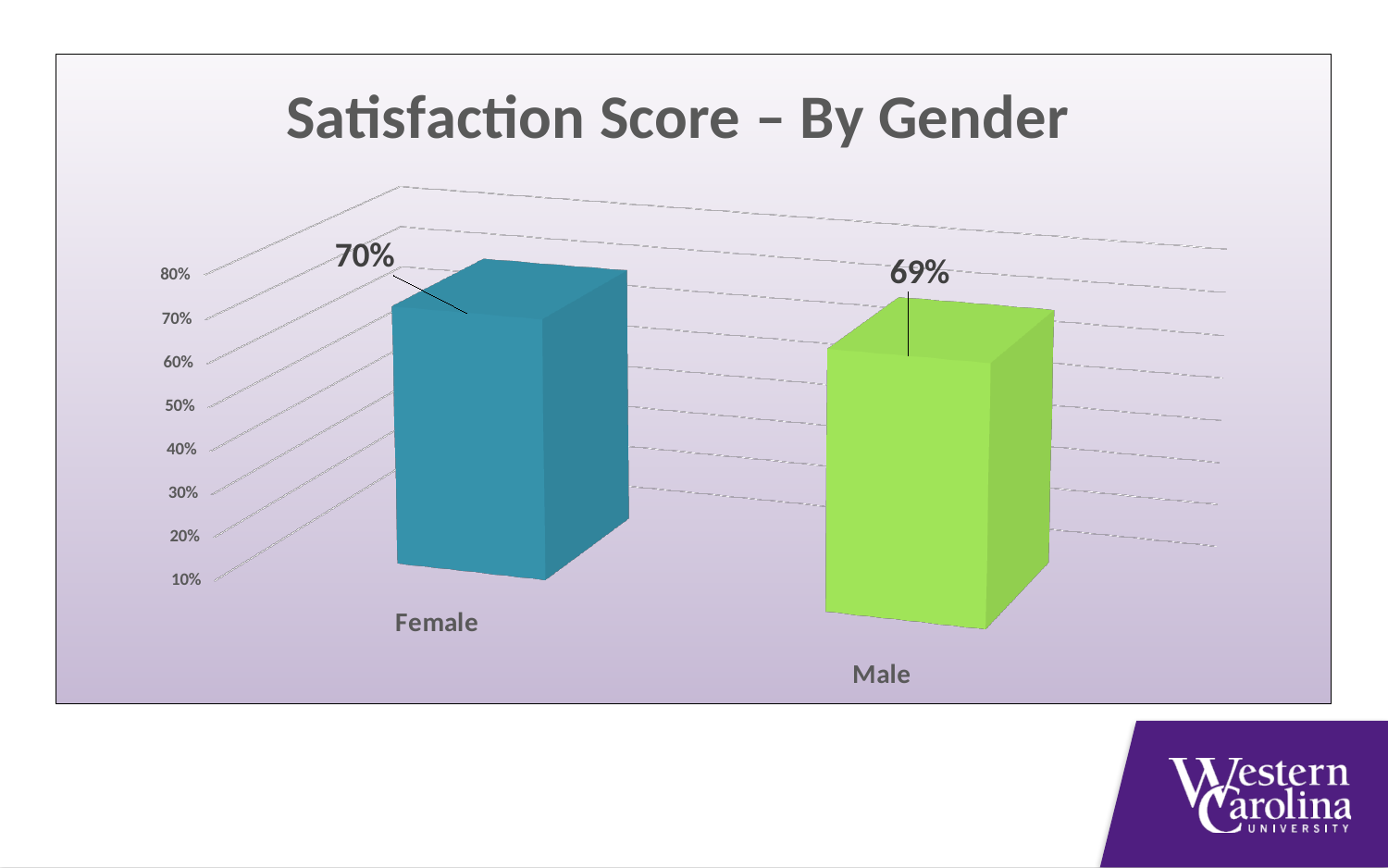
What colour is the bar for Male? green What is the satisfaction score for Female? 70% What kind of chart is shown on the slide? bar chart Is the satisfaction score for Male greater or less than 80%? less How many categories are shown in the chart? 2 What is the difference between the Female and Male satisfaction scores? 1% Which gender has the higher satisfaction score? Female Is the satisfaction score for Female greater or less than 50%? greater What is the satisfaction score for Male? 69% Which gender has the lower satisfaction score? Male Is the satisfaction score for Male larger or smaller than the score for Female? smaller What is the title of the chart? Satisfaction Score – By Gender